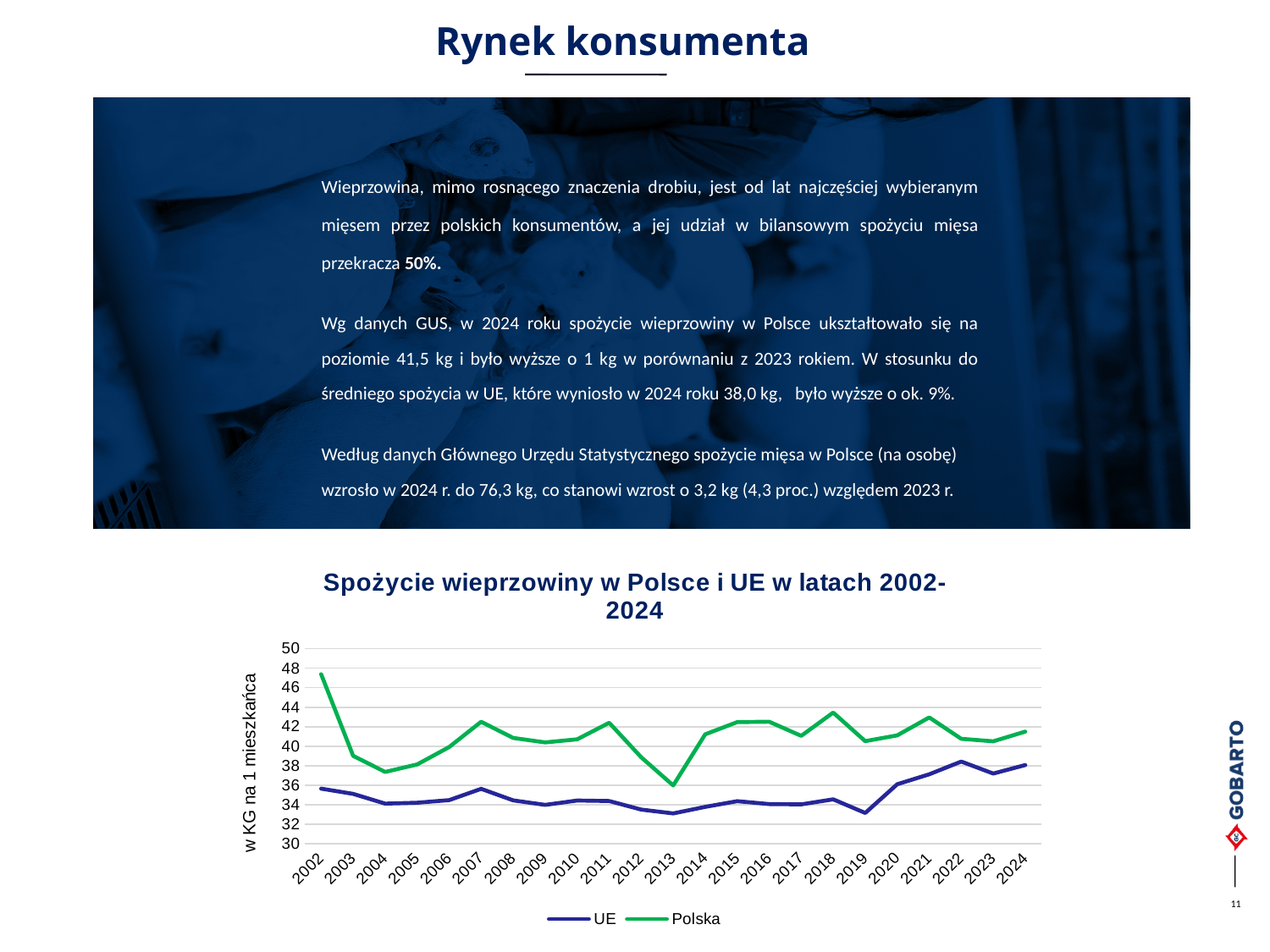
How many series does the chart legend list? 2 What is the label of the vertical axis of the chart? w KG na 1 mieszkańca Is the value for UE in 2019 greater or less than 34? less Which is larger, the Polska value in 2002 or the Polska value in 2024? 2002 How many years are plotted along the x axis of the chart? 23 Is the value for Polska in 2018 greater or less than 42? greater Does the UE series rise or fall between 2019 and 2022? rise Which series are listed in the chart legend? UE and Polska What kind of chart is shown on the slide? line chart Is the value for Polska in 2002 greater or less than 46? greater In which year is the Polska series at its lowest? 2013 In which year is the Polska series at its highest? 2002